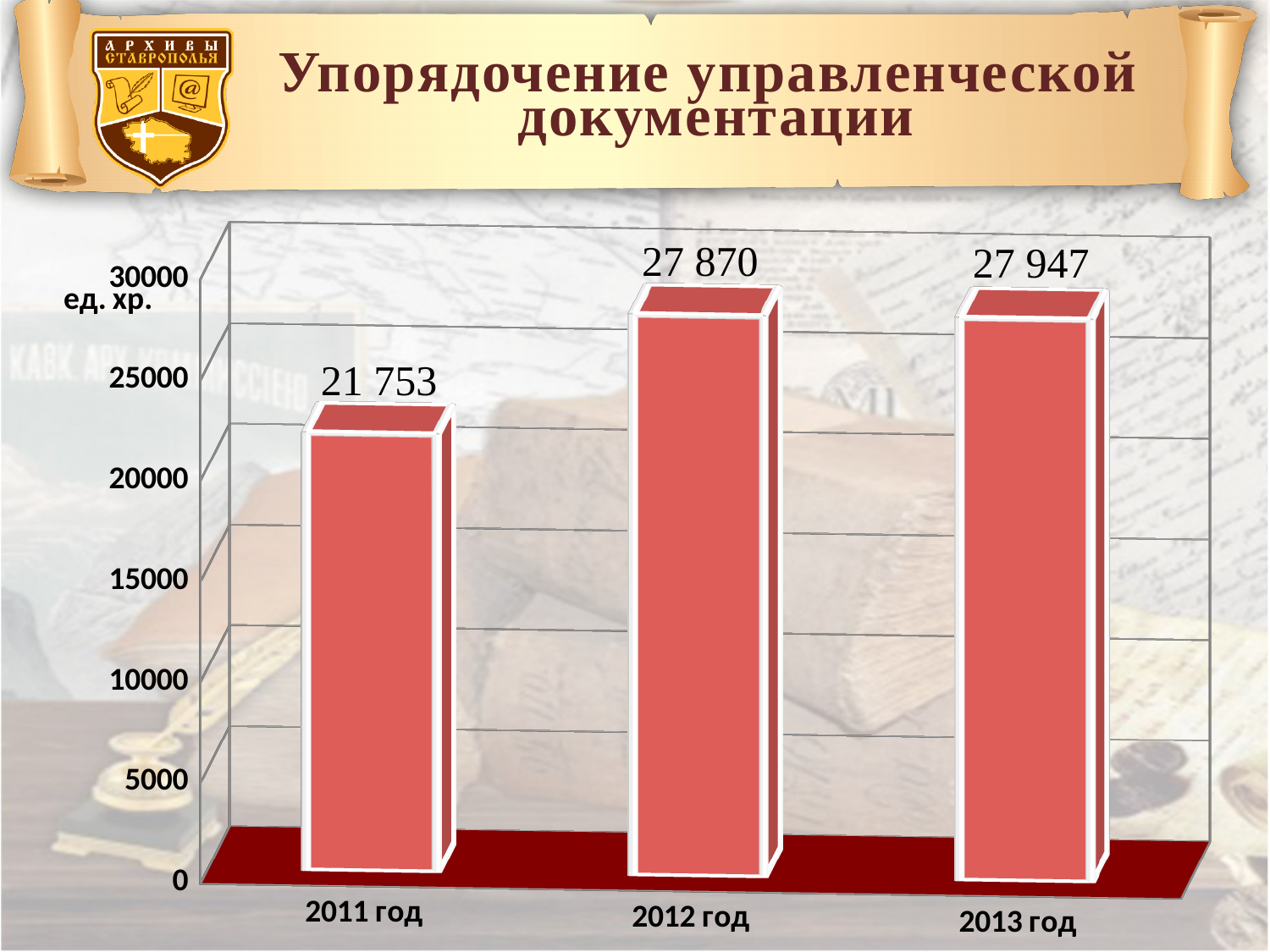
Which is larger, the value for 2011 год or the value for 2012 год? 2012 год What is the value for 2011 год? 21 753 What is the value for 2012 год? 27 870 Which year has the highest value? 2013 год What is the value for 2013 год? 27 947 What kind of chart is shown on the slide? bar chart What is the difference between the values for 2012 год and 2011 год? 6 117 Is the value for 2011 год greater or less than 20000? greater What is the difference between the values for 2013 год and 2012 год? 77 Do the values rise or fall from 2011 год to 2013 год? rise How many years are shown on the x axis? 3 Which year has the lowest value? 2011 год